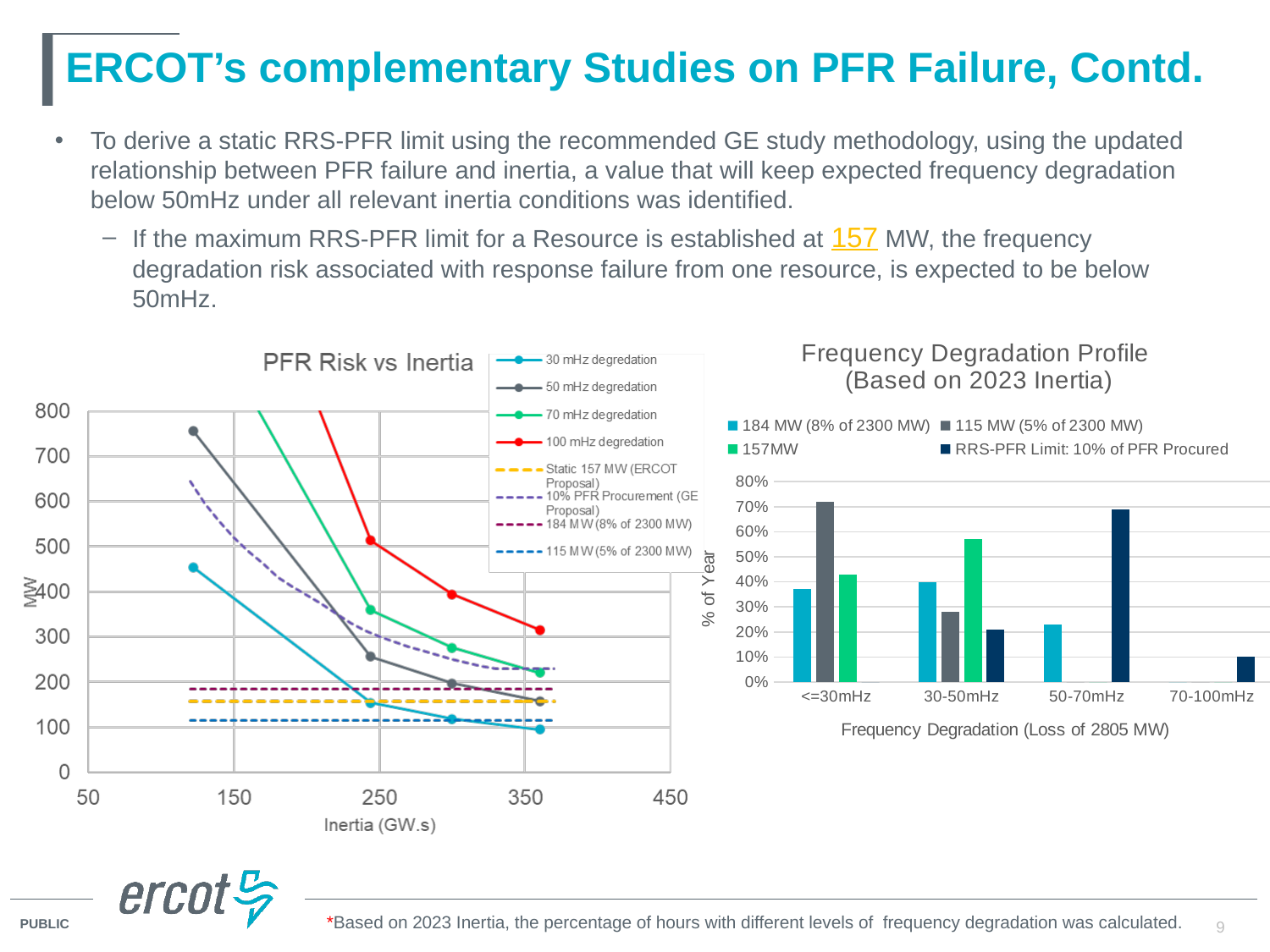
What kind of chart is the 'PFR Risk vs Inertia' chart? line chart In the 'Frequency Degradation Profile' chart, how many categories are on the x axis? 4 In the 'Frequency Degradation Profile' chart, is the value for '157MW' in the '30-50mHz' category greater or less than 50%? greater In the 'PFR Risk vs Inertia' chart, how many entries does the legend list? 8 In the 'Frequency Degradation Profile' chart, which series has the highest bar in the '<=30mHz' category? 115 MW (5% of 2300 MW) In the 'Frequency Degradation Profile' chart, how many series does the legend list? 4 In the 'Frequency Degradation Profile' chart, is the '157MW' bar larger in the '<=30mHz' category or the '30-50mHz' category? 30-50mHz What is the x-axis label of the 'PFR Risk vs Inertia' chart? Inertia (GW.s) In the 'Frequency Degradation Profile' chart, which series has the highest bar in the '50-70mHz' category? RRS-PFR Limit: 10% of PFR Procured What kind of chart is the 'Frequency Degradation Profile' chart? bar chart In the 'PFR Risk vs Inertia' chart, do the degradation lines rise or fall as inertia increases? fall